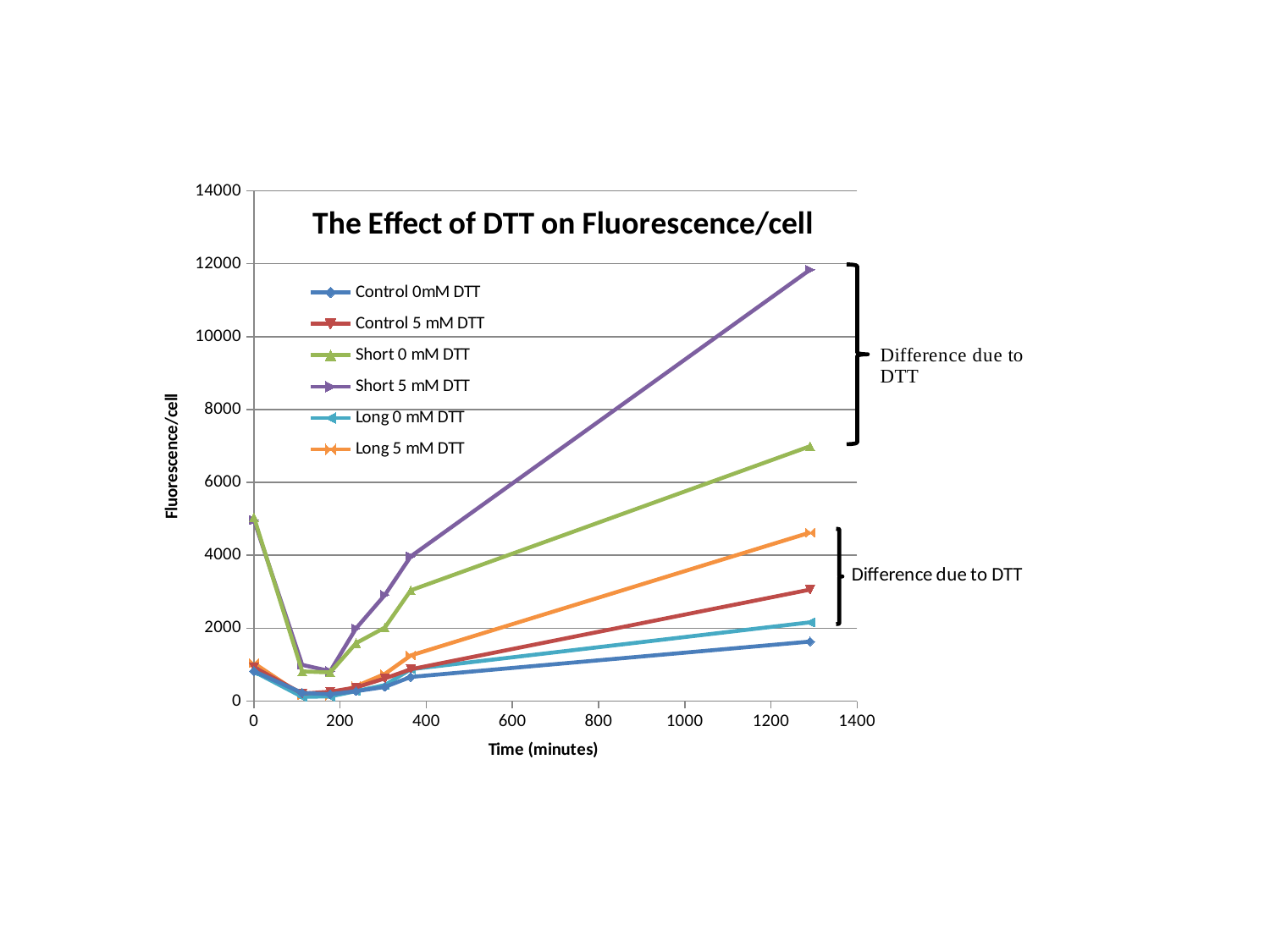
What is the label of the x axis? Time (minutes) How many series does the legend list? 6 At the final time point, which is higher: Short 0 mM DTT or Long 5 mM DTT? Short 0 mM DTT Is the final value for Long 5 mM DTT greater or less than 4000? greater Which series has the lowest fluorescence/cell value at the final time point? Control 0mM DTT Is the final value for Control 0mM DTT greater or less than 2000? less What kind of chart is shown on the slide? line chart Is the final value for Short 5 mM DTT greater or less than 10000? greater Does the Short 5 mM DTT series rise or fall between 200 and 1200 minutes? rise Which series reaches the highest fluorescence/cell value at the final time point? Short 5 mM DTT What is the title of the chart? The Effect of DTT on Fluorescence/cell